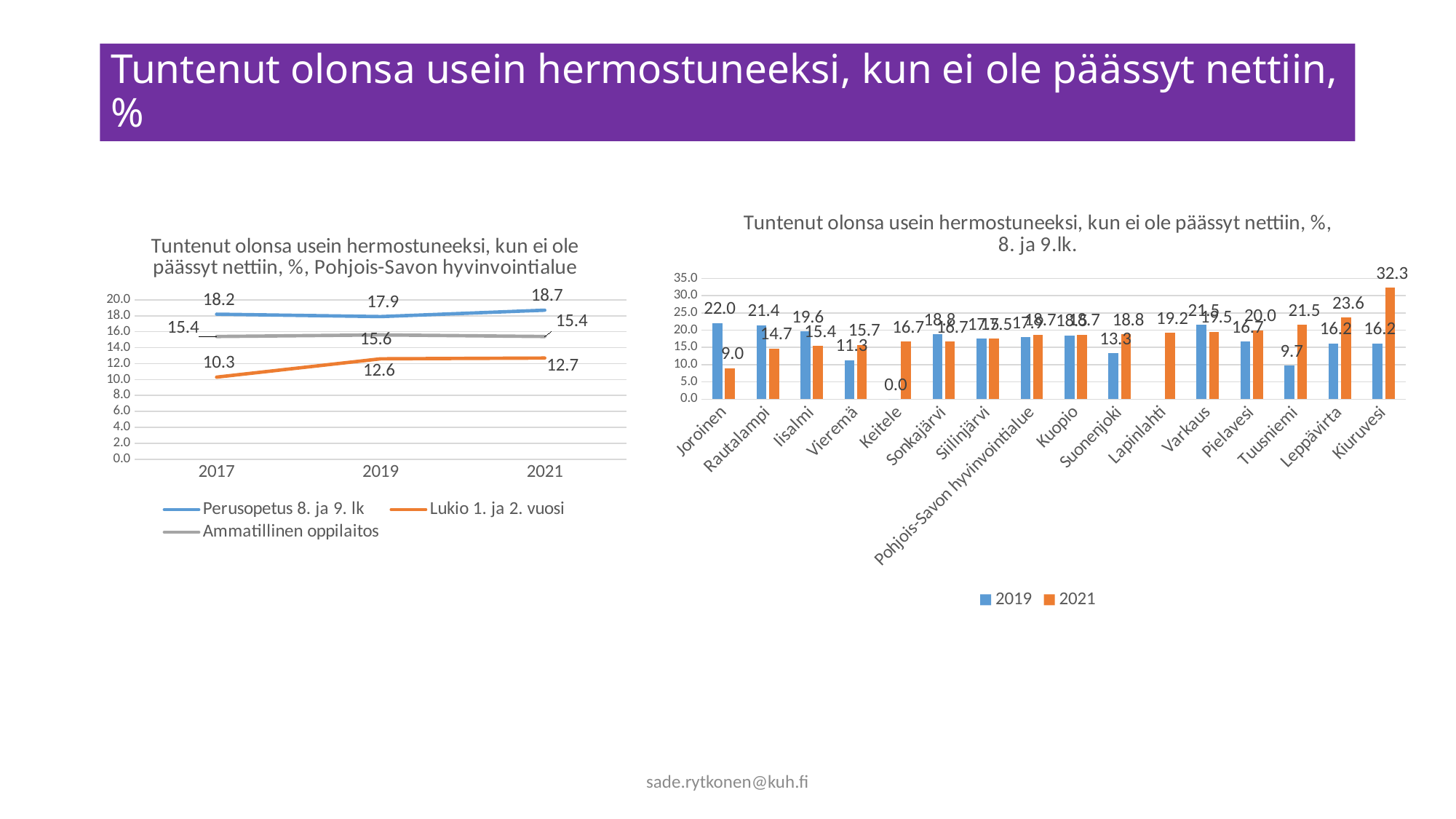
What kind of chart is the right chart (8. ja 9.lk)? bar chart In the right bar chart (8. ja 9.lk), which category has the lowest 2021 value? Joroinen In the right bar chart (8. ja 9.lk), which municipality has the highest 2021 value? Kiuruvesi In the left line chart (Pohjois-Savon hyvinvointialue), what is the value for Perusopetus 8. ja 9. lk in 2021? 18.7 In the left line chart (Pohjois-Savon hyvinvointialue), how many series does the legend list? 3 In the left line chart (Pohjois-Savon hyvinvointialue), what is the value for Lukio 1. ja 2. vuosi in 2017? 10.3 In the right bar chart (8. ja 9.lk), what is the difference between the 2019 and 2021 values for Joroinen? 13.0 In the left line chart (Pohjois-Savon hyvinvointialue), what is the difference between Perusopetus 8. ja 9. lk and Lukio 1. ja 2. vuosi in 2019? 5.3 In the right bar chart (8. ja 9.lk), which is larger for Tuusniemi: the 2019 value or the 2021 value? 2021 In the right bar chart (8. ja 9.lk), how many categories are shown on the x axis? 16 In the left line chart (Pohjois-Savon hyvinvointialue), does the Lukio 1. ja 2. vuosi series rise or fall from 2017 to 2021? rise In the right bar chart (8. ja 9.lk), what is the 2021 value for Kiuruvesi? 32.3